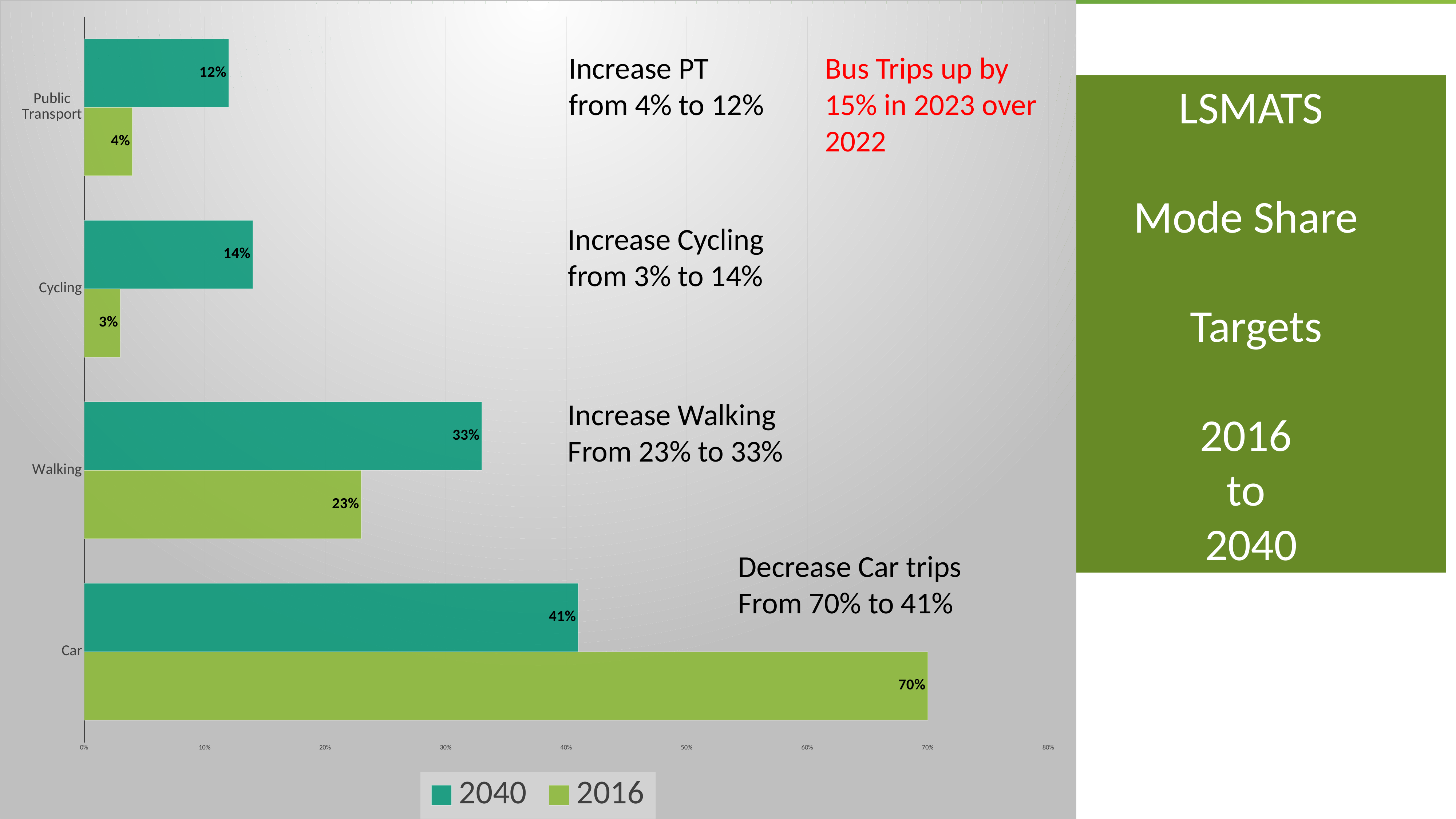
Which series is shown in the lighter green colour? 2016 Which category has the lowest 2040 value? Public Transport What is the 2040 value for Public Transport? 12% How many categories are shown on the chart? 4 What is the 2016 value for Cycling? 3% What is the 2040 value for Walking? 33% How many series does the legend list? 2 What is the difference between the 2016 and 2040 values for Car? 29% What kind of chart is shown on the slide? Bar chart Which is larger for Walking, the 2040 value or the 2016 value? 2040 What is the 2016 value for Car? 70% Which category has the highest 2016 value? Car